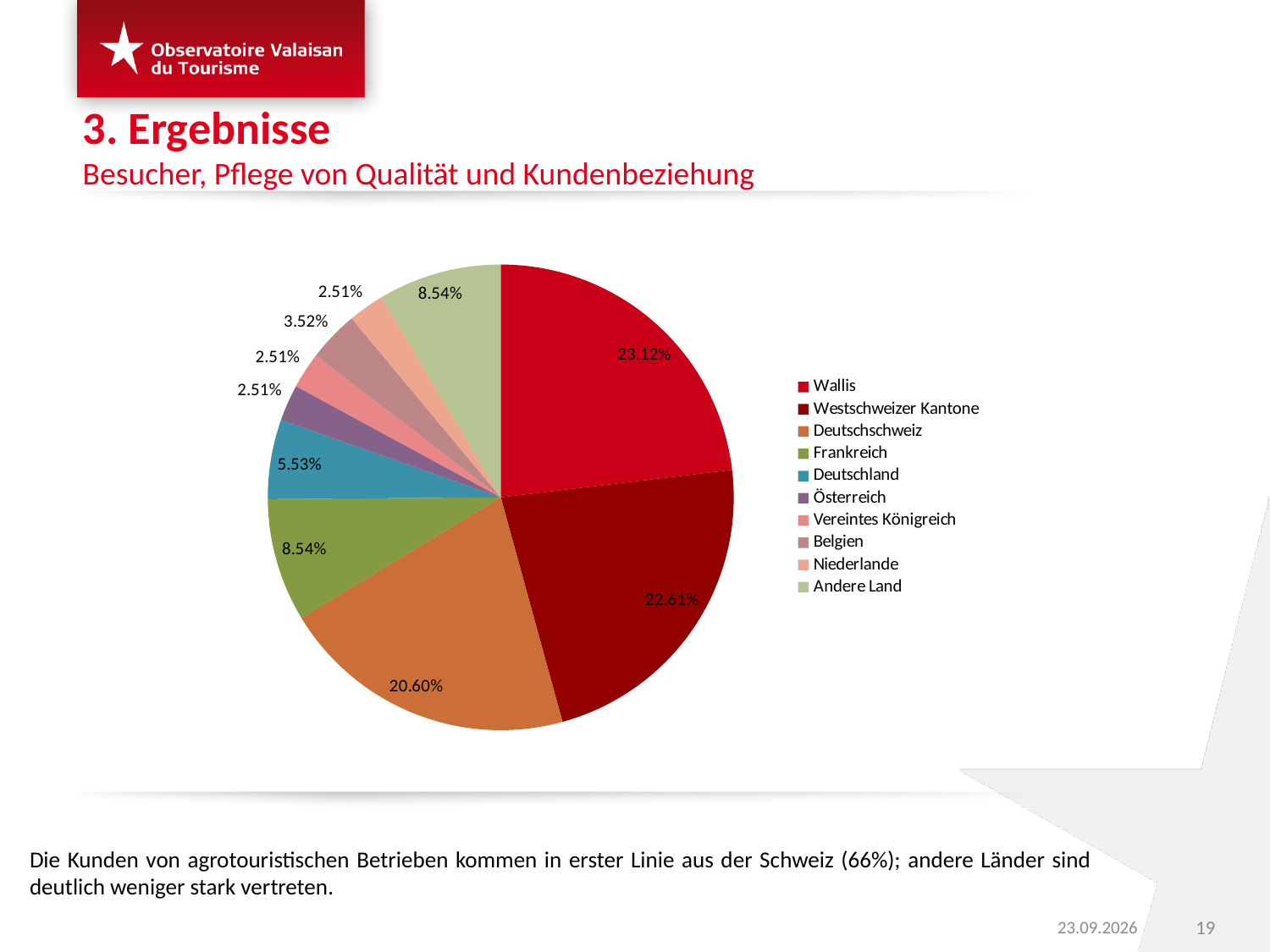
What is the last entry listed in the legend? Andere Land What is the difference between the values for Wallis and Westschweizer Kantone? 0.51% What kind of chart is shown on the slide? pie chart What is the value for Deutschschweiz? 20.60% What is the combined share of Wallis, Westschweizer Kantone and Deutschschweiz? 66.33% Which is larger, the value for Frankreich or the value for Deutschland? Frankreich Which category has the largest slice of the pie? Wallis What is the value for Westschweizer Kantone? 22.61% What share of the pie does Wallis have? 23.12% What is the value for Belgien? 3.52% How many categories does the legend list? 10 What is the value for Deutschland? 5.53%